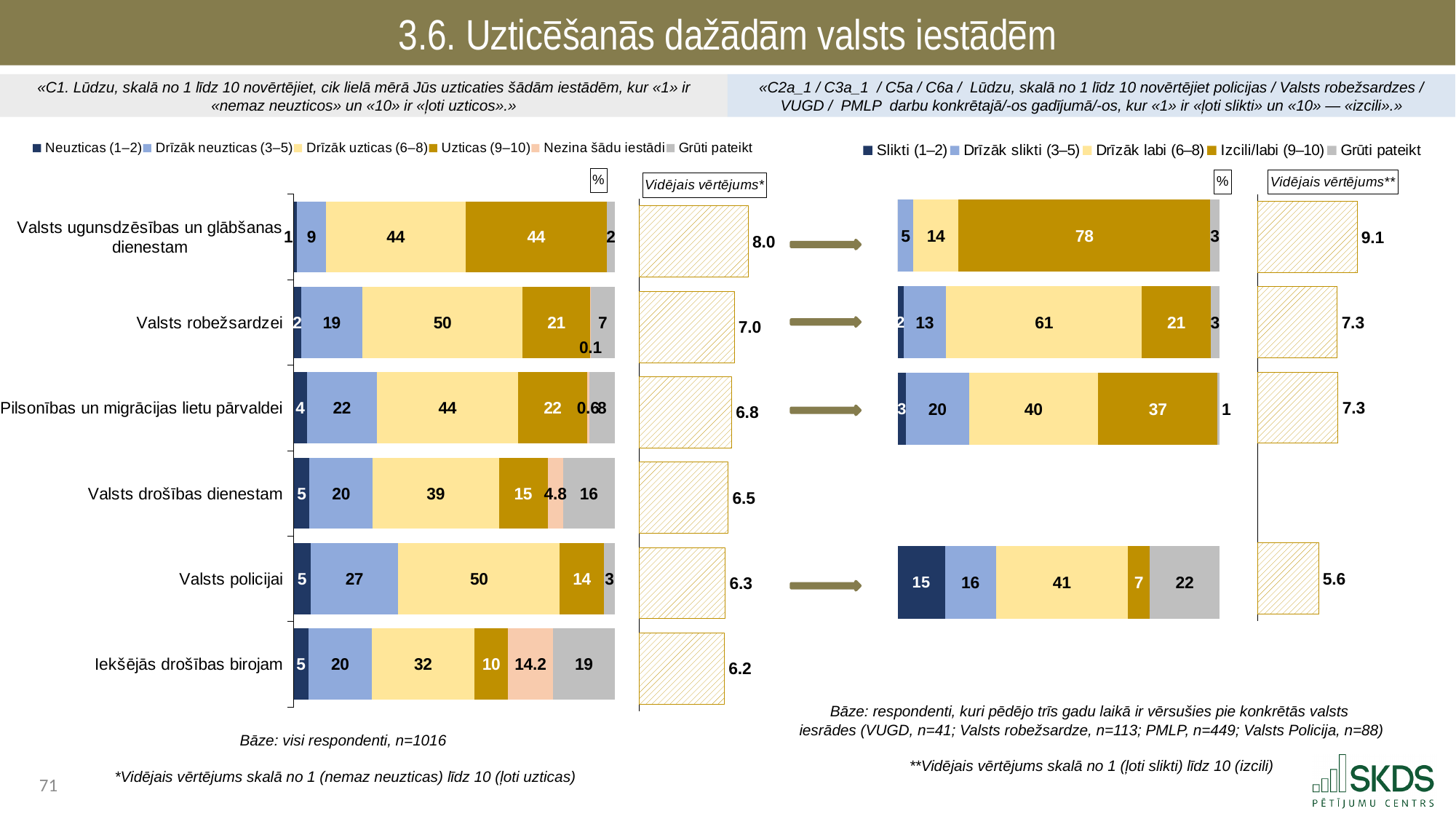
In the left chart, what is the difference between the 'Drīzāk uzticas (6–8)' values for Valsts policijai and Iekšējās drošības birojam? 18 In the right 'Vidējais vērtējums**' column, what is the lowest average value shown? 5.6 How many series does the legend of the left chart list? 6 In the right chart, what is the 'Grūti pateikt' value for Valsts policijai? 22 How many institutions (categories) are shown in the right chart? 4 In the right chart, what is the 'Izcili/labi (9–10)' value for Valsts ugunsdzēsības un glābšanas dienestam? 78 In the left chart, what percentage of respondents answered 'Uzticas (9–10)' for Valsts ugunsdzēsības un glābšanas dienestam? 44 In the left chart, which has the larger 'Drīzāk neuzticas (3–5)' value: Valsts policijai or Valsts robežsardzei? Valsts policijai In the left 'Vidējais vērtējums*' column, which institution has the highest average value? Valsts ugunsdzēsības un glābšanas dienestam How many institutions (categories) are shown in the left chart? 6 In the left chart, what is the 'Grūti pateikt' value for Iekšējās drošības birojam? 19 What type of chart is used on the left side of the slide? Stacked bar chart